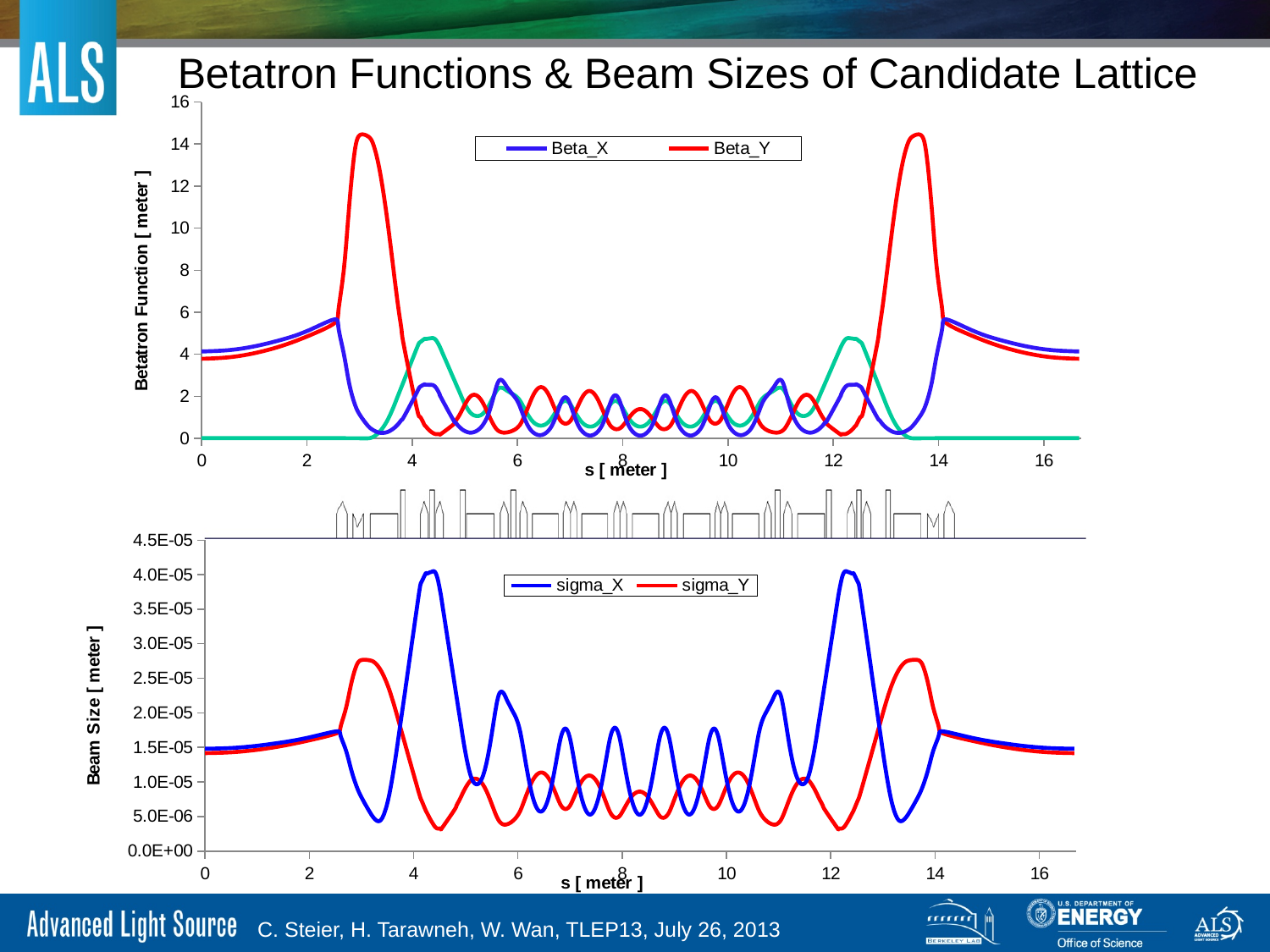
In the top chart (Betatron Function), is the peak value of Beta_Y near s = 3 greater or less than 12? greater What is the y-axis title of the top chart? Betatron Function [ meter ] In the bottom chart (Beam Size), which series reaches the highest peak value, sigma_X or sigma_Y? sigma_X In the bottom chart (Beam Size), how many series does the legend list? 2 In the top chart (Betatron Function), is the value of Beta_X at s = 0 greater or less than 6? less What kind of chart is the bottom chart (Beam Size)? line chart In the bottom chart (Beam Size), is the peak value of sigma_X near s = 4 greater or less than 3.5E-05? greater In the top chart (Betatron Function), how many series does the legend list? 2 What kind of chart is the top chart (Betatron Function)? line chart What is the y-axis title of the bottom chart? Beam Size [ meter ] In the top chart (Betatron Function), which series reaches the highest peak value, Beta_X or Beta_Y? Beta_Y